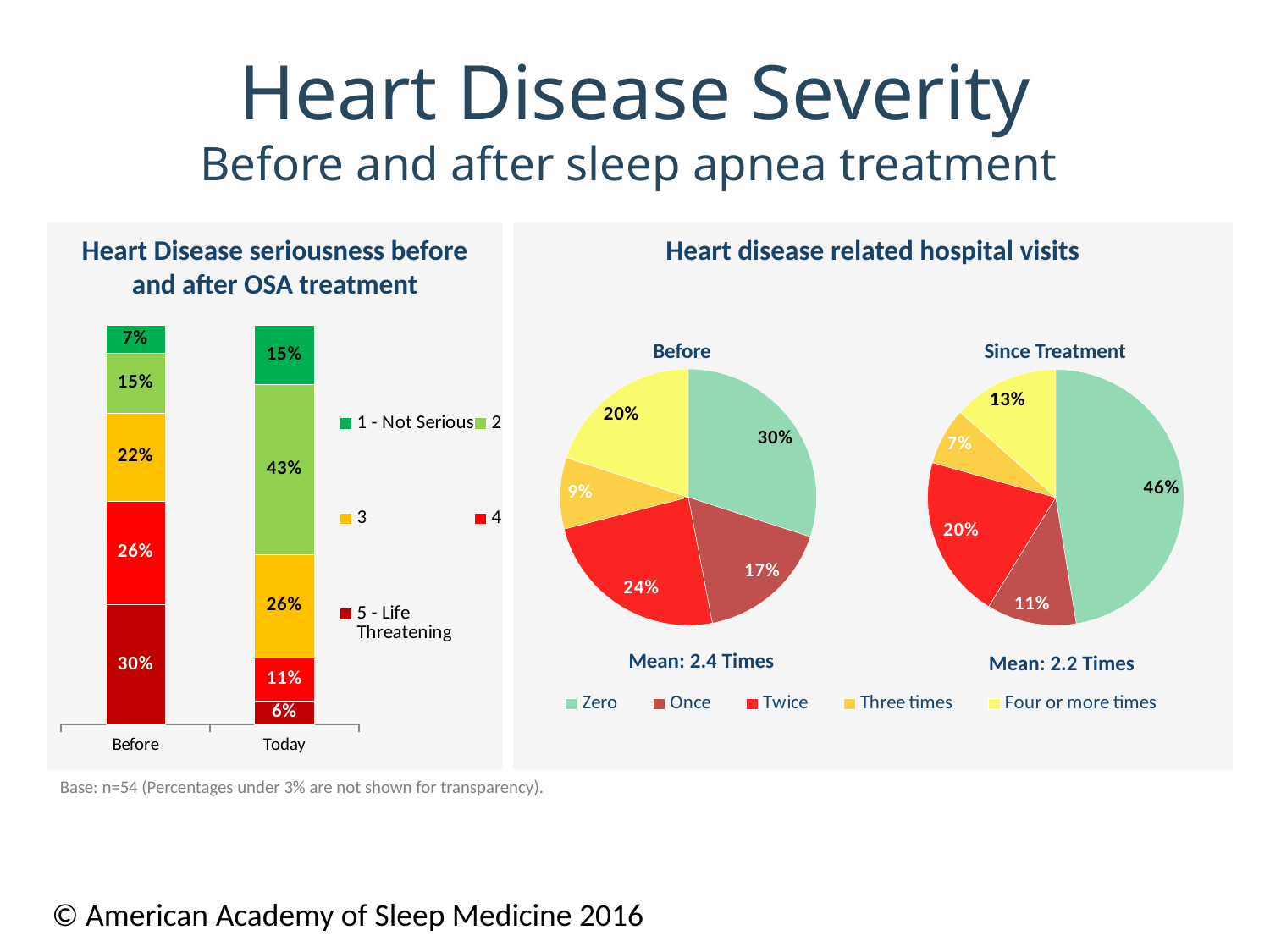
In the 'Since Treatment' pie chart under 'Heart disease related hospital visits', which category is the smallest? Three times Under 'Heart disease related hospital visits', is the 'Zero' share larger in the Before pie or the Since Treatment pie? Since Treatment In the 'Since Treatment' pie chart under 'Heart disease related hospital visits', which category is the largest? Zero In the 'Heart Disease seriousness before and after OSA treatment' chart, what is the value for category 2 in the Today bar? 43% Under 'Heart disease related hospital visits', what is the mean number of visits shown for the Before pie chart? 2.4 Times In the 'Heart Disease seriousness before and after OSA treatment' chart, how many series does the legend list? 5 In the 'Heart Disease seriousness before and after OSA treatment' chart, what is the total of the Today stacked bar? 101% In the 'Heart Disease seriousness before and after OSA treatment' chart, what is the difference between the '5 - Life Threatening' values for Before and Today? 24% In the 'Heart Disease seriousness before and after OSA treatment' chart, what is the value for '5 - Life Threatening' in the Before bar? 30% What kind of chart is 'Heart Disease seriousness before and after OSA treatment'? Stacked bar chart In the 'Before' pie chart under 'Heart disease related hospital visits', what share is 'Twice'? 24% In the 'Heart Disease seriousness before and after OSA treatment' chart, what is the value for '1 - Not Serious' in the Before bar? 7%